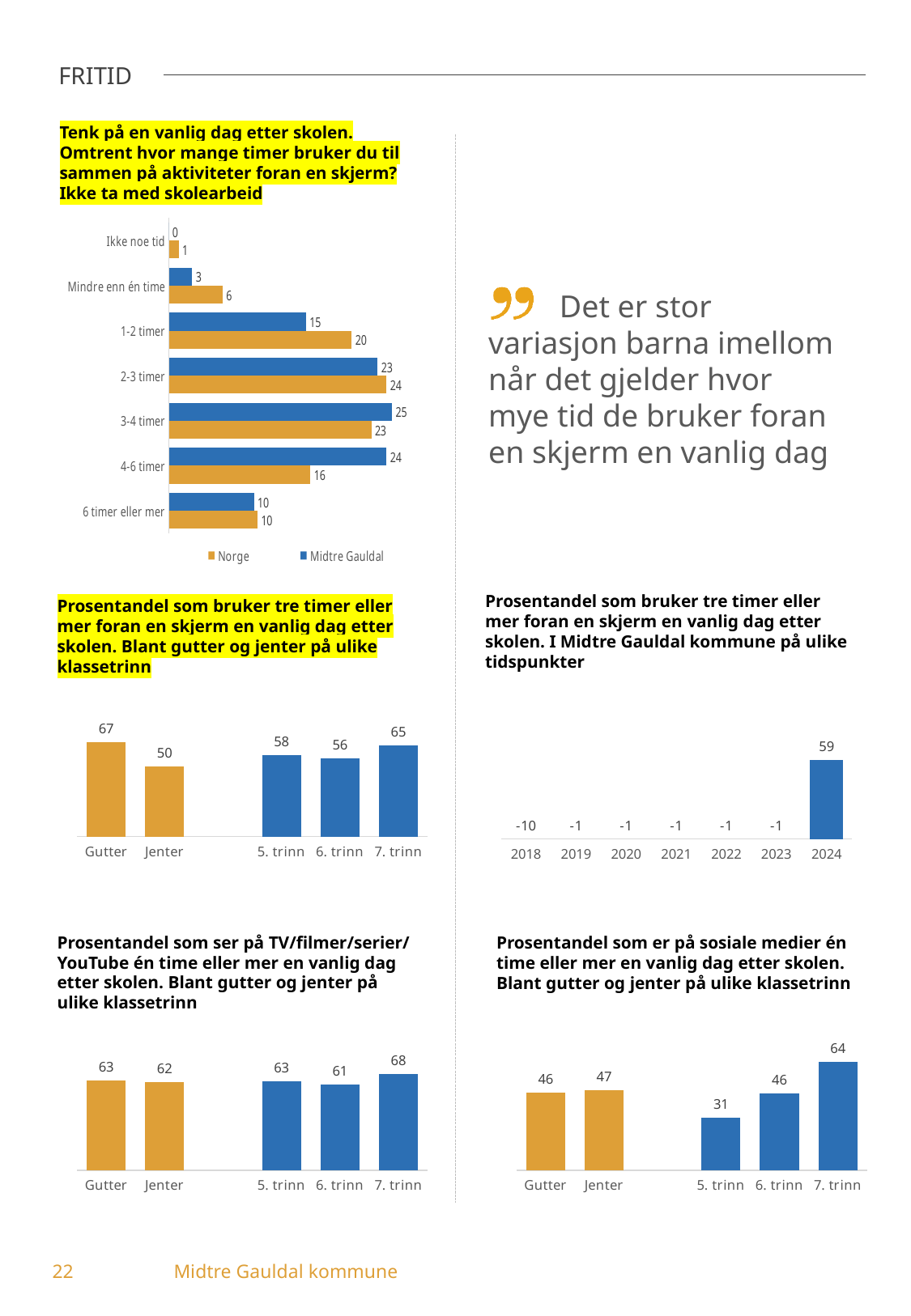
In the top-left chart about hours spent in front of a screen, how many series does the legend list? 2 In the chart 'Prosentandel som ser på TV/filmer/serier/YouTube én time eller mer', which category has the highest value? 7. trinn In the chart 'Prosentandel som bruker tre timer eller mer foran en skjerm... Blant gutter og jenter på ulike klassetrinn', which category has the lowest value? Jenter In the chart 'Prosentandel som bruker tre timer eller mer foran en skjerm... I Midtre Gauldal kommune på ulike tidspunkter', what is the value for 2024? 59 In the chart 'Prosentandel som bruker tre timer eller mer foran en skjerm... Blant gutter og jenter på ulike klassetrinn', what is the value for Gutter? 67 In the top-left chart about hours spent in front of a screen, how many categories are shown? 7 In the top-left chart about hours spent in front of a screen, what is the value for Midtre Gauldal in the '3-4 timer' category? 25 In the chart 'Prosentandel som ser på TV/filmer/serier/YouTube én time eller mer', what is the difference between Gutter and Jenter? 1 In the top-left chart about hours spent in front of a screen, what is the difference between Midtre Gauldal and Norge in the '4-6 timer' category? 8 In the chart 'Prosentandel som er på sosiale medier én time eller mer', what is the value for 5. trinn? 31 In the top-left chart about hours spent in front of a screen, what is the value for Norge in the '1-2 timer' category? 20 In the chart 'Prosentandel som er på sosiale medier én time eller mer', which is larger, the value for 6. trinn or 7. trinn? 7. trinn